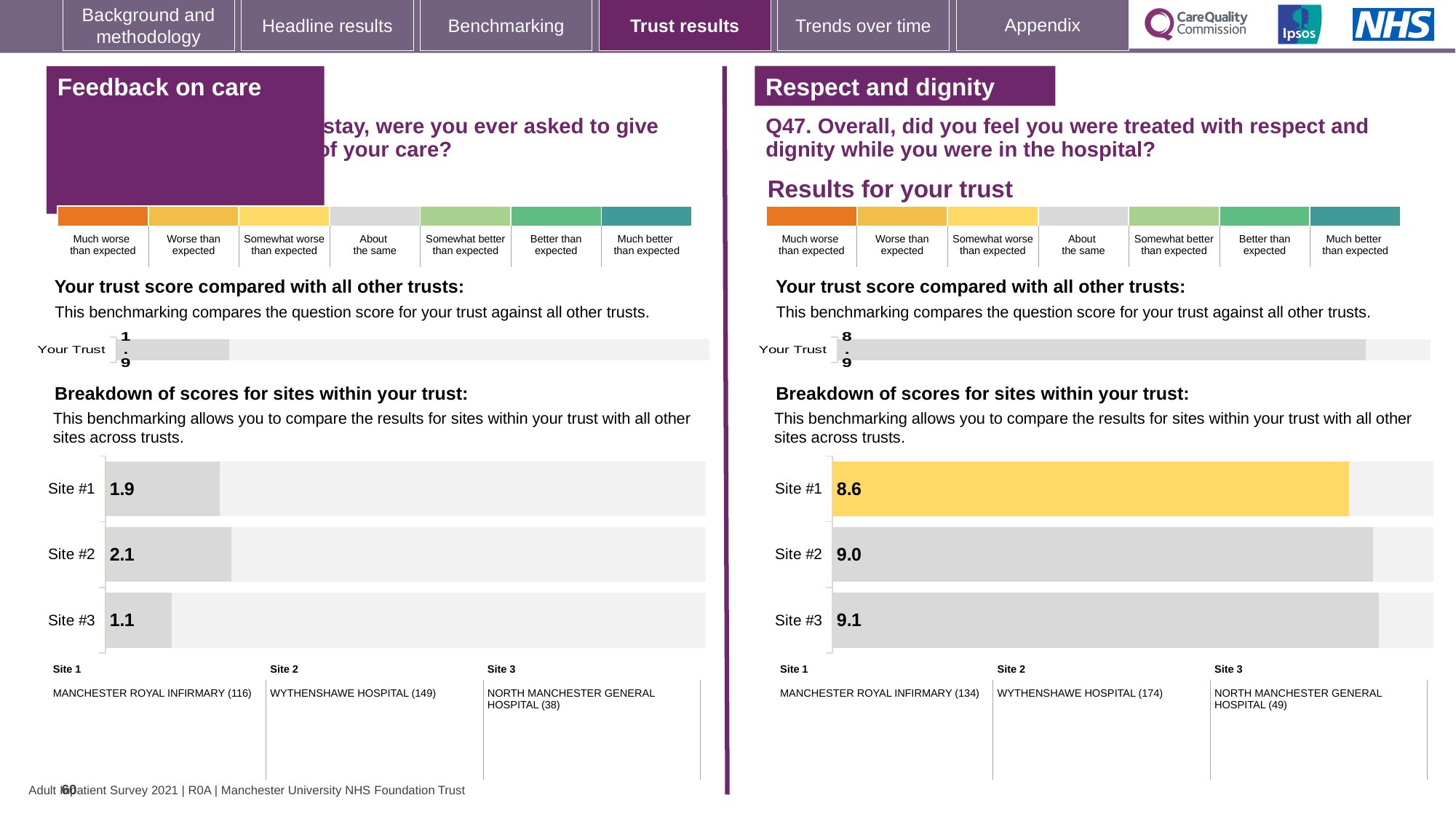
In the 'Respect and dignity' 'Your trust score compared with all other trusts' chart, what is the score for Your Trust? 8.9 In the 'Feedback on care' site breakdown chart, what is the difference between the scores for Site #2 and Site #3? 1.0 In the 'Respect and dignity' site breakdown chart, what is the score for Site #3? 9.1 In the 'Respect and dignity' site breakdown chart, what is the difference between the scores for Site #3 and Site #1? 0.5 In the 'Respect and dignity' site breakdown chart, which site has the lowest score? Site #1 In the 'Feedback on care' site breakdown chart, which site has the highest score? Site #2 How many sites are shown in the 'Feedback on care' site breakdown chart? 3 In the 'Feedback on care' site breakdown chart, what is the score for Site #2? 2.1 What type of chart is used for the 'Respect and dignity' site breakdown? Bar chart In the 'Respect and dignity' site breakdown chart, what is the score for Site #1? 8.6 In the 'Feedback on care' site breakdown chart, which site has the lowest score? Site #3 In the 'Feedback on care' site breakdown chart, what is the score for Site #1? 1.9